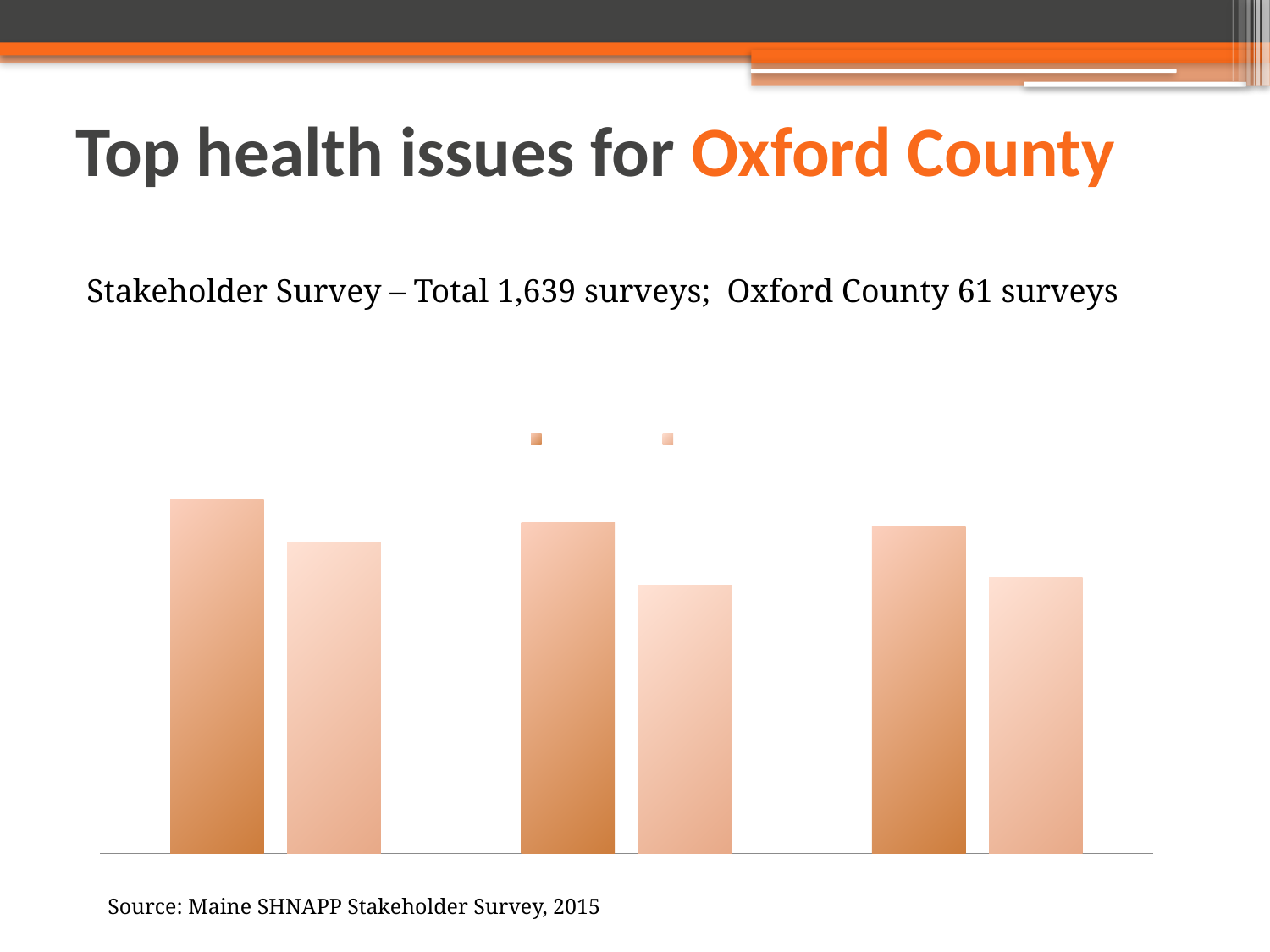
Is the lighter bar in the leftmost group taller or shorter than the lighter bar in the rightmost group? taller Which group of bars has the tallest darker (left) bar: the leftmost, middle, or rightmost group? the leftmost group Does the chart display any data labels or axis values? No In the middle group of bars, is the darker (left) bar or the lighter (right) bar taller? the darker (left) bar In the rightmost group of bars, is the darker (left) bar or the lighter (right) bar taller? the darker (left) bar Which group of bars has the tallest lighter (right) bar: the leftmost, middle, or rightmost group? the leftmost group How many groups of bars (categories) does the chart show? 3 What kind of chart is shown on the slide? bar chart What colours are the two series in the chart? dark orange and light orange How many series does the chart's legend list? 2